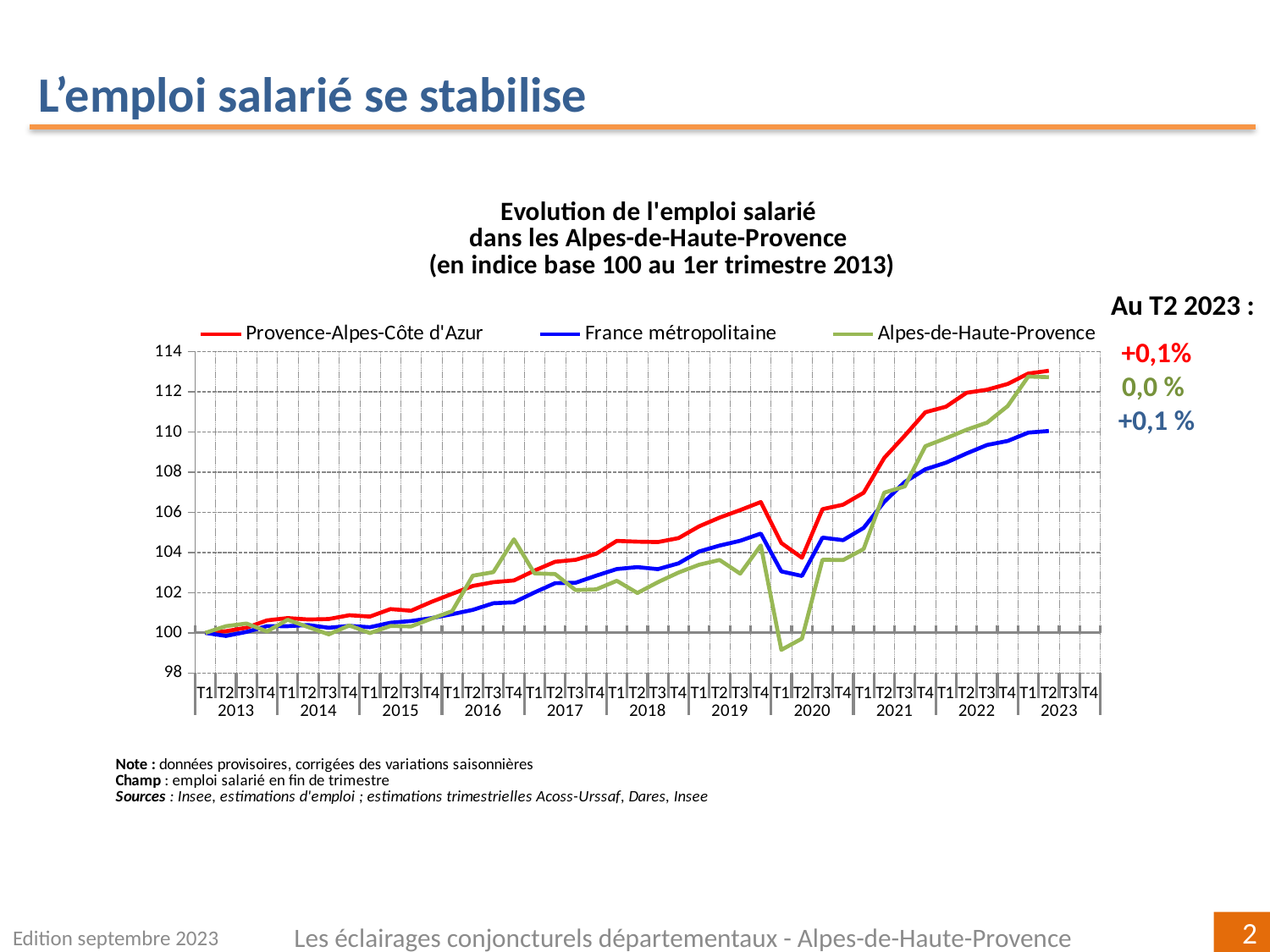
Is the value for France métropolitaine at T2 2023 greater or less than 112? less Overall, do the values for France métropolitaine rise or fall from 2013 to 2023? rise Is the value for Provence-Alpes-Côte d'Azur at T2 2023 greater or less than 112? greater What kind of chart is shown on the slide? line chart Which series is drawn in red? Provence-Alpes-Côte d'Azur Which series has the lowest value at T2 2023? France métropolitaine At T4 2016, which is higher: Alpes-de-Haute-Provence or France métropolitaine? Alpes-de-Haute-Provence According to the annotation, what is the change for Provence-Alpes-Côte d'Azur at T2 2023? +0,1% According to the annotation, what is the change for Alpes-de-Haute-Provence at T2 2023? 0,0 % What is the title of the chart? Evolution de l'emploi salarié dans les Alpes-de-Haute-Provence (en indice base 100 au 1er trimestre 2013) How many series does the legend list? 3 Is the value for Alpes-de-Haute-Provence at T1 2020 greater or less than 100? less